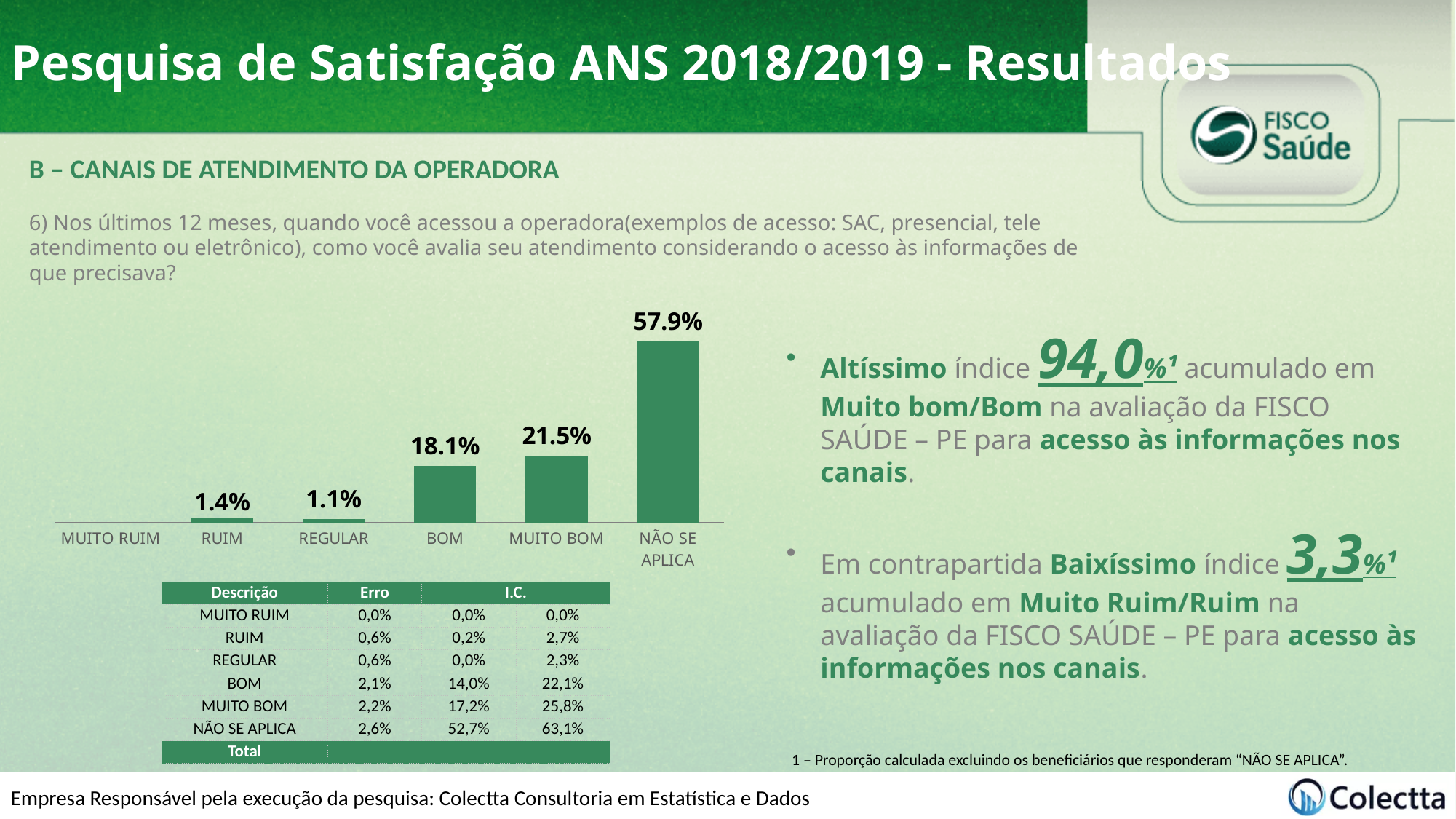
What is the value for MUITO BOM in the bar chart? 21.5% What is the difference between the values for NÃO SE APLICA and MUITO BOM? 36.4% What kind of chart is shown on the slide? Bar chart Which is larger, the value for RUIM or the value for REGULAR? RUIM Which category has the highest value in the bar chart? NÃO SE APLICA Which is larger, the value for BOM or the value for MUITO BOM? MUITO BOM What is the difference between the values for MUITO BOM and BOM? 3.4% How many categories are shown on the x axis of the bar chart? 6 What is the value for REGULAR in the bar chart? 1.1% What is the value for BOM in the bar chart? 18.1% What is the value for RUIM in the bar chart? 1.4% What is the value for NÃO SE APLICA in the bar chart? 57.9%